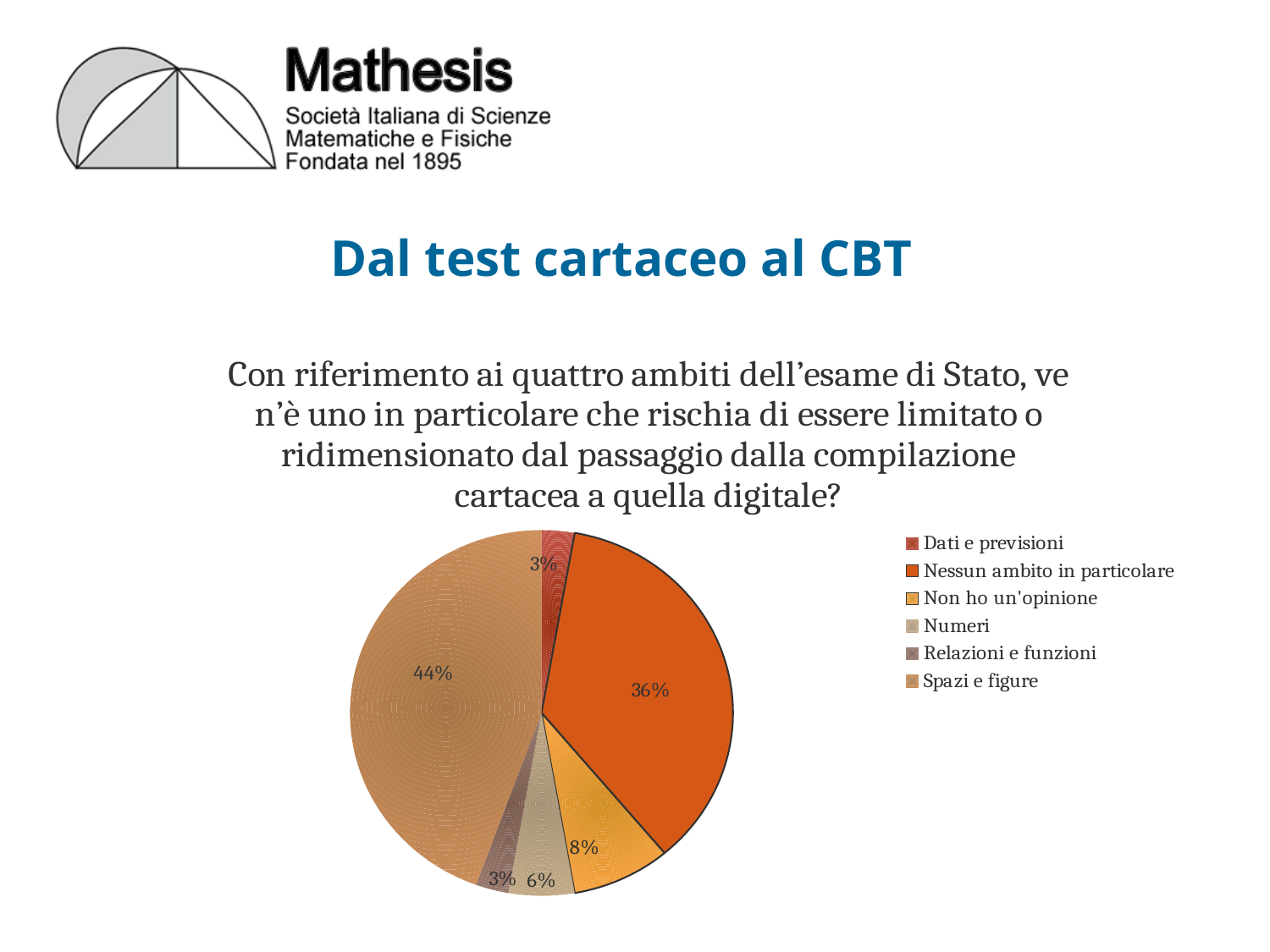
Which category has the largest slice of the pie? Spazi e figure Which is larger, the slice for "Non ho un'opinione" or the slice for "Numeri"? Non ho un'opinione What is the title of the slide containing the pie chart? Dal test cartaceo al CBT What share of the pie does "Non ho un'opinione" represent? 8% What is the combined share of "Numeri" and "Relazioni e funzioni"? 9% What share of the pie does "Dati e previsioni" represent? 3% What share of the pie does "Numeri" represent? 6% How many categories does the legend list? 6 What share of the pie does "Nessun ambito in particolare" represent? 36% What kind of chart is shown on the slide? pie chart What is the difference in percentage points between "Spazi e figure" and "Nessun ambito in particolare"? 8 What share of the pie does "Spazi e figure" represent? 44%